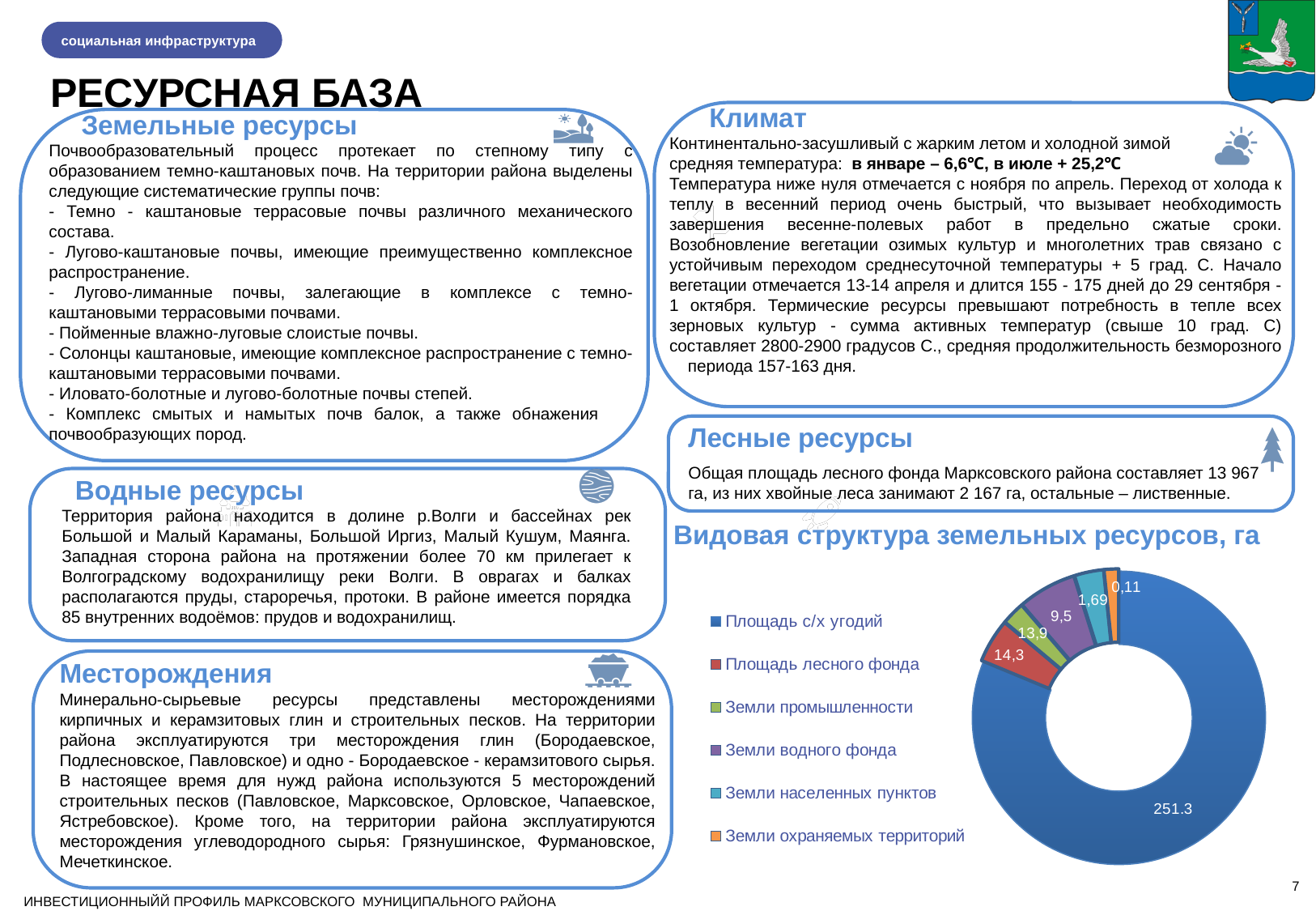
What is the value for Земли населенных пунктов in the chart 'Видовая структура земельных ресурсов, га'? 1,69 In the chart 'Видовая структура земельных ресурсов, га', what is the difference between Площадь лесного фонда and Земли водного фонда? 4,8 What kind of chart is 'Видовая структура земельных ресурсов, га'? doughnut chart Which category has the smallest value in the chart 'Видовая структура земельных ресурсов, га'? Земли охраняемых территорий What is the value for Площадь с/х угодий in the chart 'Видовая структура земельных ресурсов, га'? 251.3 What is the value for Земли промышленности in the chart 'Видовая структура земельных ресурсов, га'? 13,9 What is the value for Площадь лесного фонда in the chart 'Видовая структура земельных ресурсов, га'? 14,3 What is the value for Земли водного фонда in the chart 'Видовая структура земельных ресурсов, га'? 9,5 How many categories are shown in the chart 'Видовая структура земельных ресурсов, га'? 6 What is the value for Земли охраняемых территорий in the chart 'Видовая структура земельных ресурсов, га'? 0,11 In the chart 'Видовая структура земельных ресурсов, га', which is larger: Площадь лесного фонда or Земли промышленности? Площадь лесного фонда Which category has the largest value in the chart 'Видовая структура земельных ресурсов, га'? Площадь с/х угодий